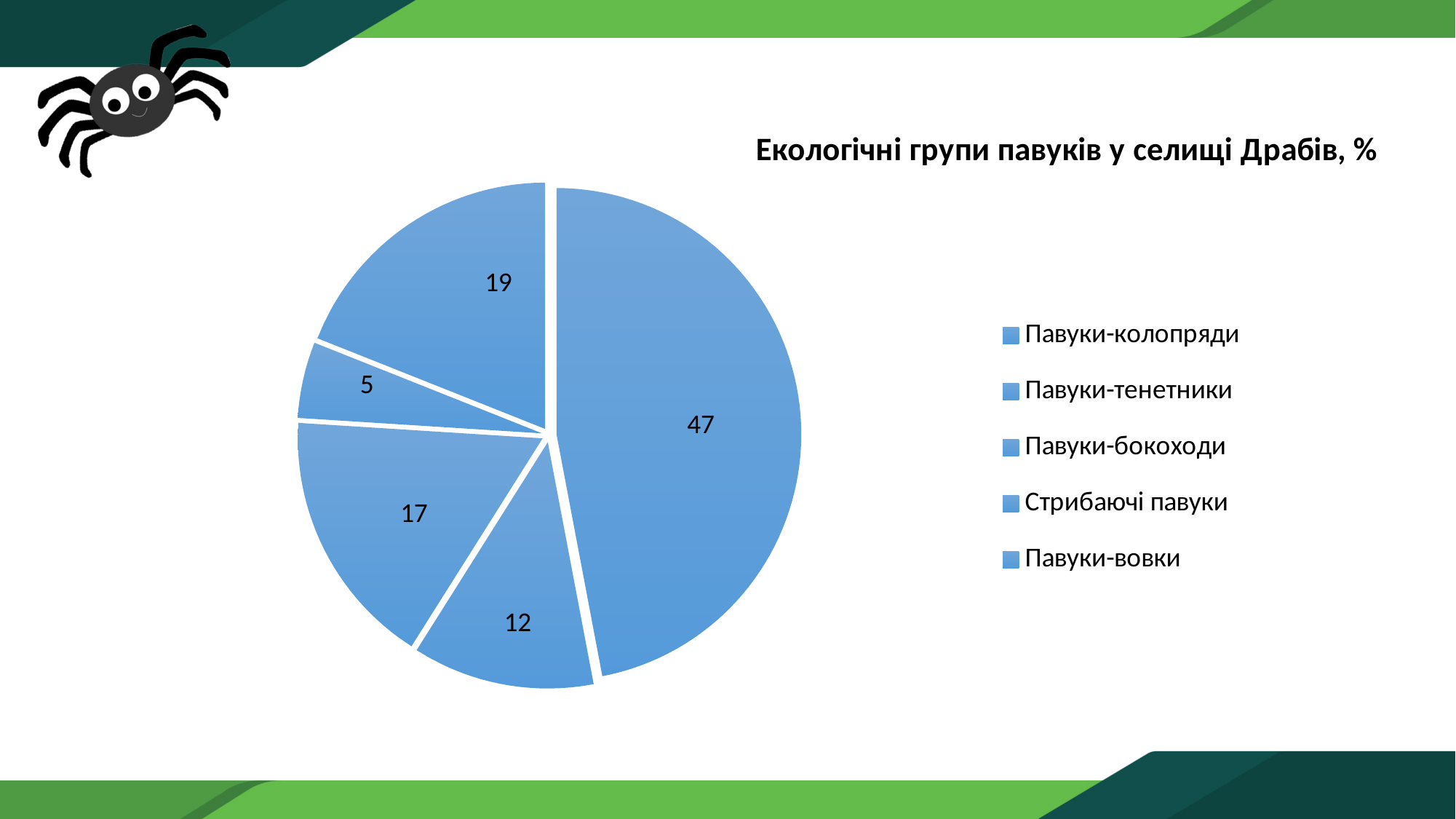
What is the difference between the largest slice value (47) and the smallest slice value (5)? 42 How many slices does the pie chart have? 5 What is the sum of all the slice values shown on the pie chart? 100 What is the value of the largest slice in the pie chart? 47 What kind of chart is shown on the slide? pie chart How many entries does the legend list? 5 Which legend entry is listed first? Павуки-колопряди What is the value of the smallest slice in the pie chart? 5 Is the largest slice value greater or less than 40? greater What is the difference between the slices labelled 19 and 12? 7 Which is larger: the slice labelled 19 or the slice labelled 17? 19 What is the title of the chart? Екологічні групи павуків у селищі Драбів, %